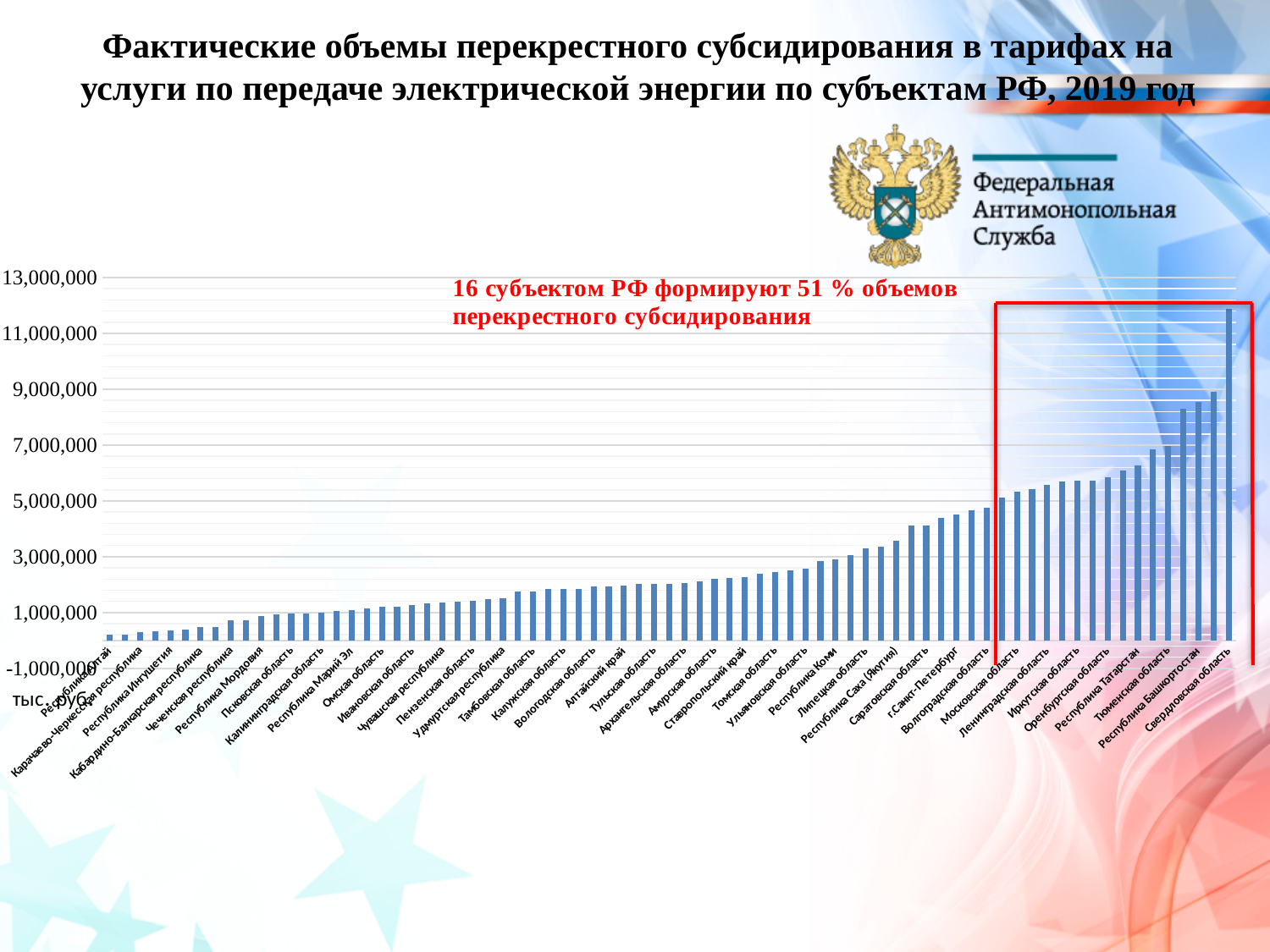
Which is larger, the value for Республика Коми or for Республика Ингушетия? Республика Коми Is the value for Чеченская республика greater or less than 1,000,000? less Which region has the highest value on the chart? Свердловская область Is the value for Республика Татарстан greater or less than 5,000,000? greater Do the bar values rise or fall from left to right along the x axis? rise According to the annotation on the chart, what share of cross-subsidy volumes is formed by 16 subjects of the RF? 51 % Is the value for Свердловская область greater or less than 9,000,000? greater What kind of chart is shown on the slide? bar chart Which is larger, the value for Свердловская область or for Тюменская область? Свердловская область